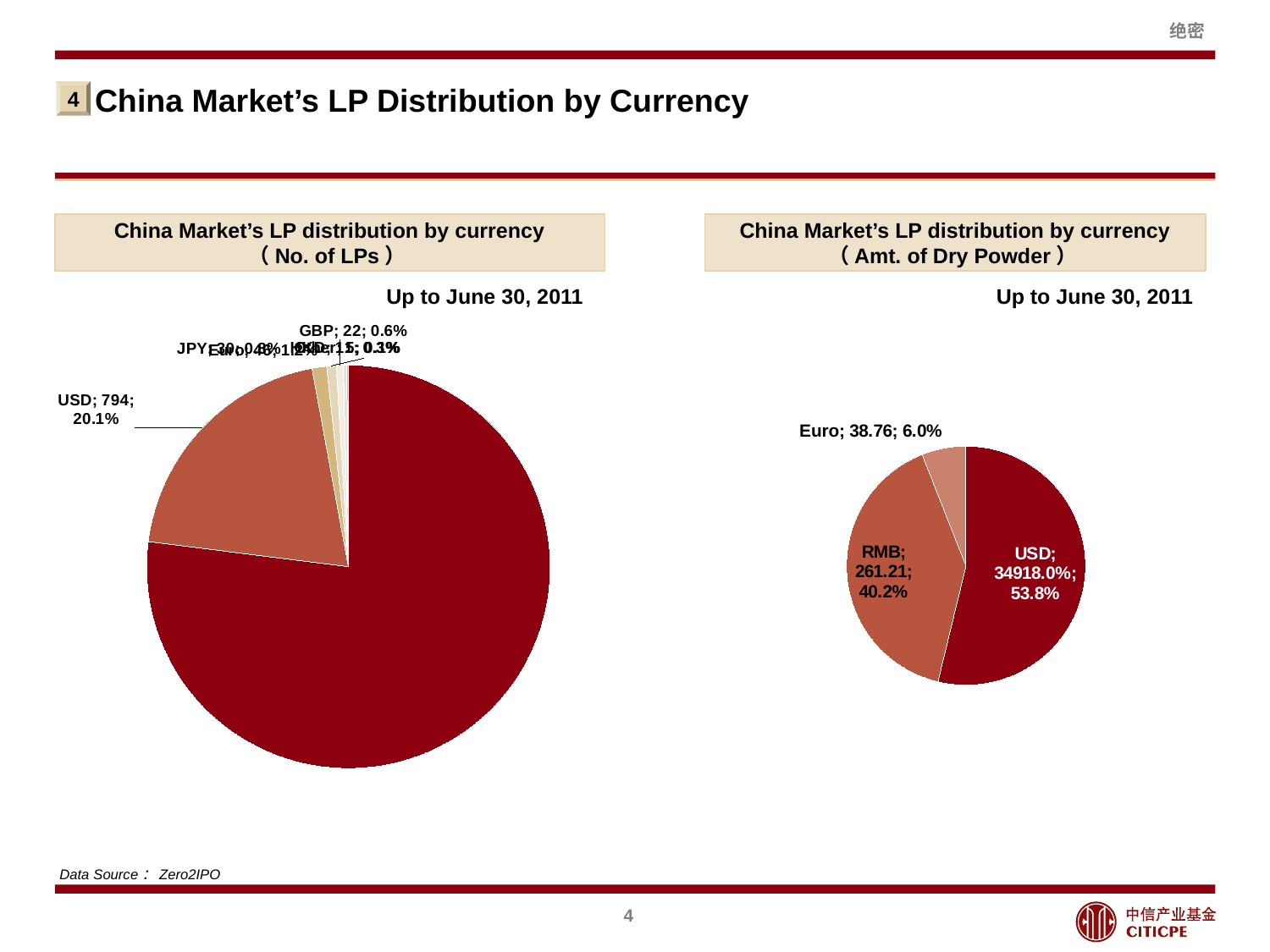
In the No. of LPs chart, what share of the pie does GBP hold? 0.6% In the Amt. of Dry Powder chart, what is the difference in percentage share between RMB and Euro? 34.2% In the No. of LPs chart, which has more LPs, USD or GBP? USD In the Amt. of Dry Powder chart, which currency has the smallest slice? Euro In the Amt. of Dry Powder chart, what is the value shown for RMB? 261.21 What kind of chart is used on the right side of the slide for the Amt. of Dry Powder distribution? Pie chart In the No. of LPs chart, how many LPs are shown for USD? 794 In the Amt. of Dry Powder chart, which currency has the largest slice? USD In the Amt. of Dry Powder chart, what is the value shown for Euro? 38.76 In the Amt. of Dry Powder chart, what share of the pie does RMB hold? 40.2% In the Amt. of Dry Powder chart, what share of the pie does USD hold? 53.8% In the Amt. of Dry Powder chart, how many slices does the pie have? 3